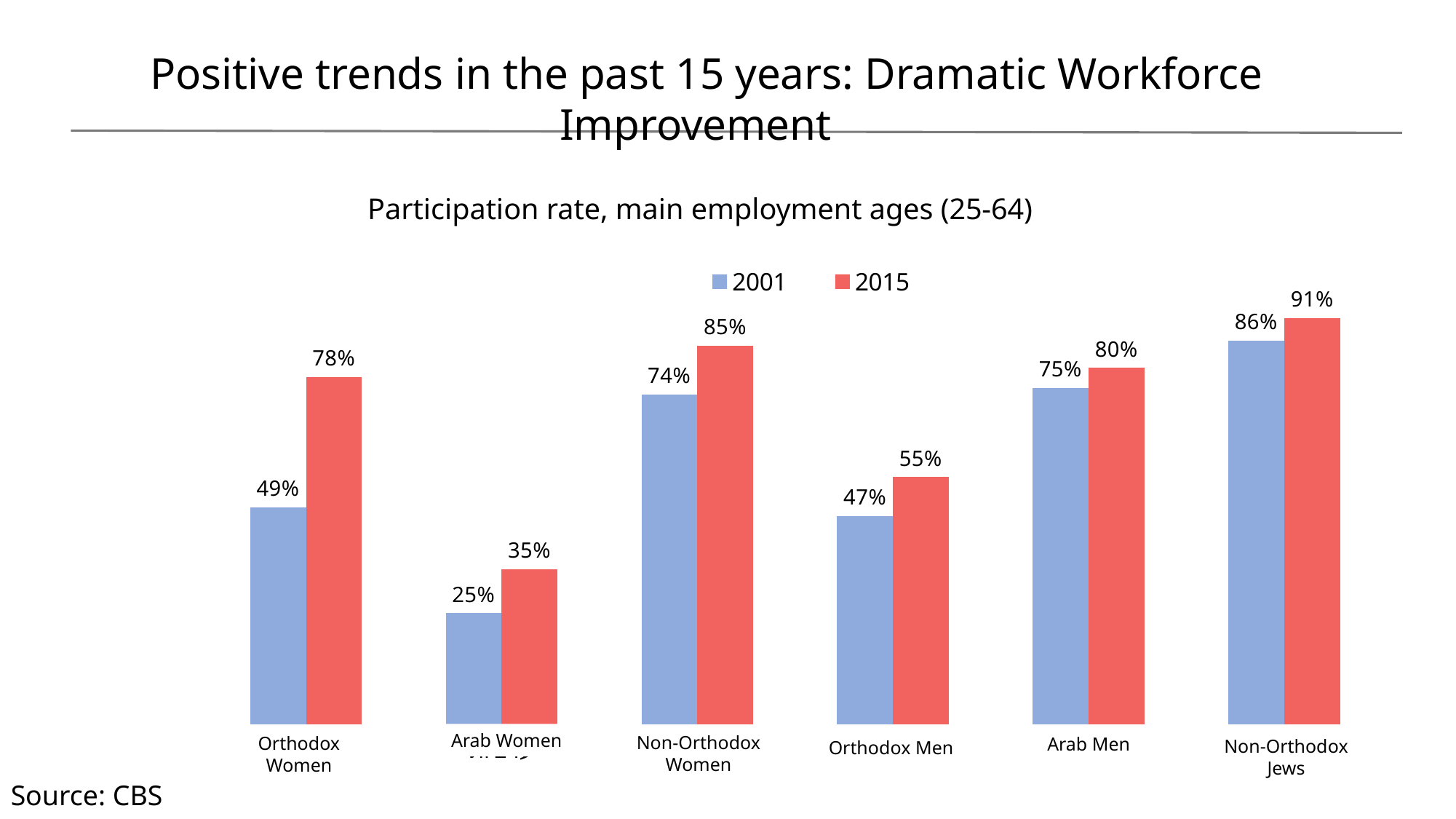
What was the participation rate for Non-Orthodox Jews in 2001? 86% What was the participation rate for Orthodox Women in 2015? 78% Which category had the highest participation rate in 2015? Non-Orthodox Jews By how many percentage points did the participation rate for Orthodox Women increase from 2001 to 2015? 29 percentage points Which was higher in 2001: the participation rate for Orthodox Men or for Orthodox Women? Orthodox Women What type of chart is shown on the slide? Bar chart How many categories are shown on the x axis of the chart? 6 What was the participation rate for Orthodox Men in 2015? 55% How many series does the legend list? 2 Which category had the lowest participation rate in 2001? Arab Women What is the difference between the 2015 participation rates of Non-Orthodox Women and Arab Men? 5 percentage points What was the participation rate for Arab Women in 2001? 25%